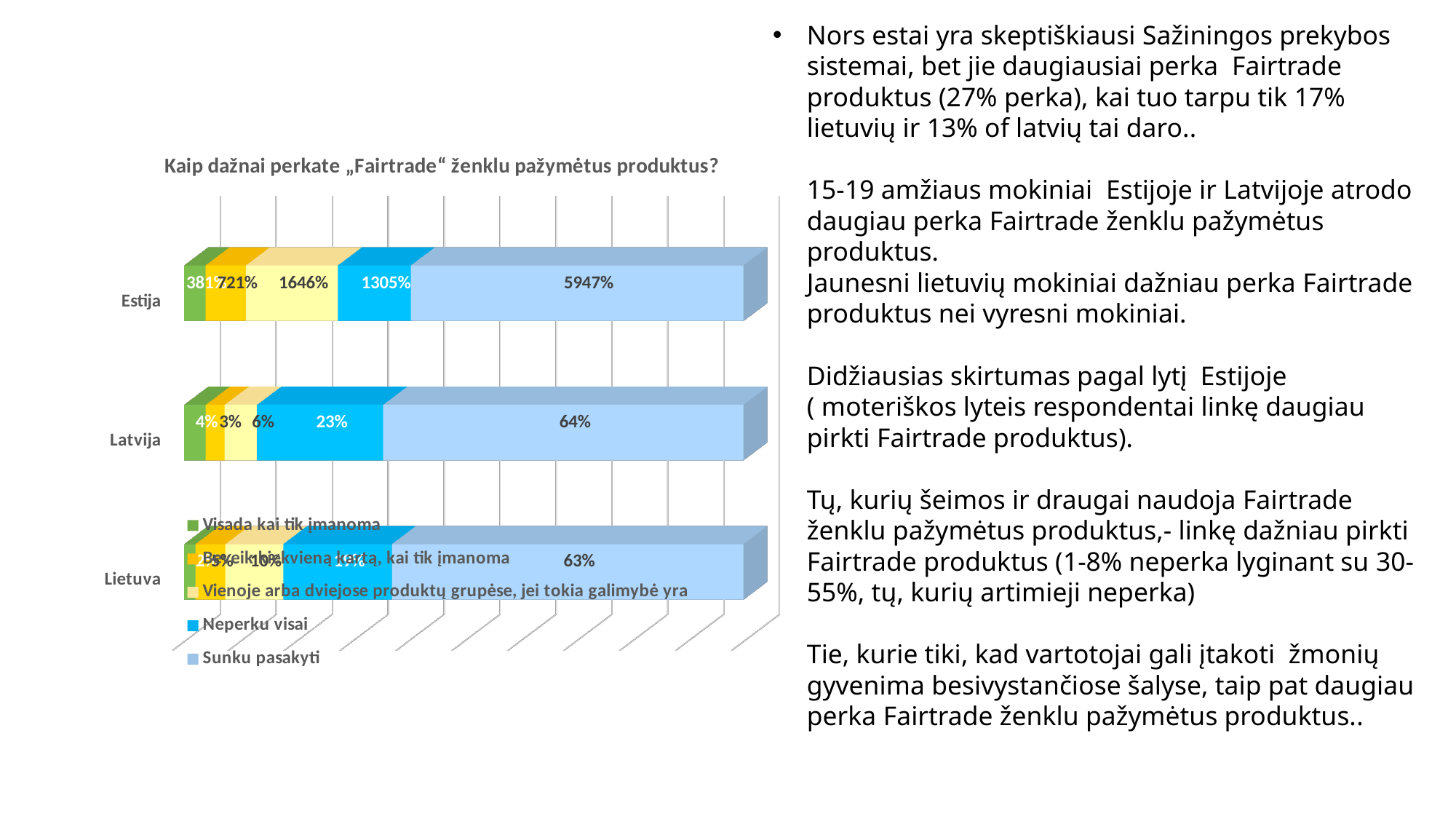
What kind of chart is shown on the slide? Stacked bar chart How many countries (categories) are shown on the chart? 3 What is the value for "Neperku visai" for Latvija? 23% How many series does the chart legend list? 5 What is the title of the chart? Kaip dažnai perkate „Fairtrade“ ženklu pažymėtus produktus? Which series has the largest value in the Latvija bar? Sunku pasakyti What is the value for "Visada kai tik įmanoma" for Latvija? 4% Which colour represents "Neperku visai" in the legend? Blue Which series has the smallest value in the Latvija bar? Beveik kiekvieną kartą, kai tik įmanoma What is the value for "Sunku pasakyti" for Latvija? 64% What is the value for "Sunku pasakyti" for Lietuva? 63% What is the difference between "Sunku pasakyti" and "Neperku visai" for Latvija? 41%